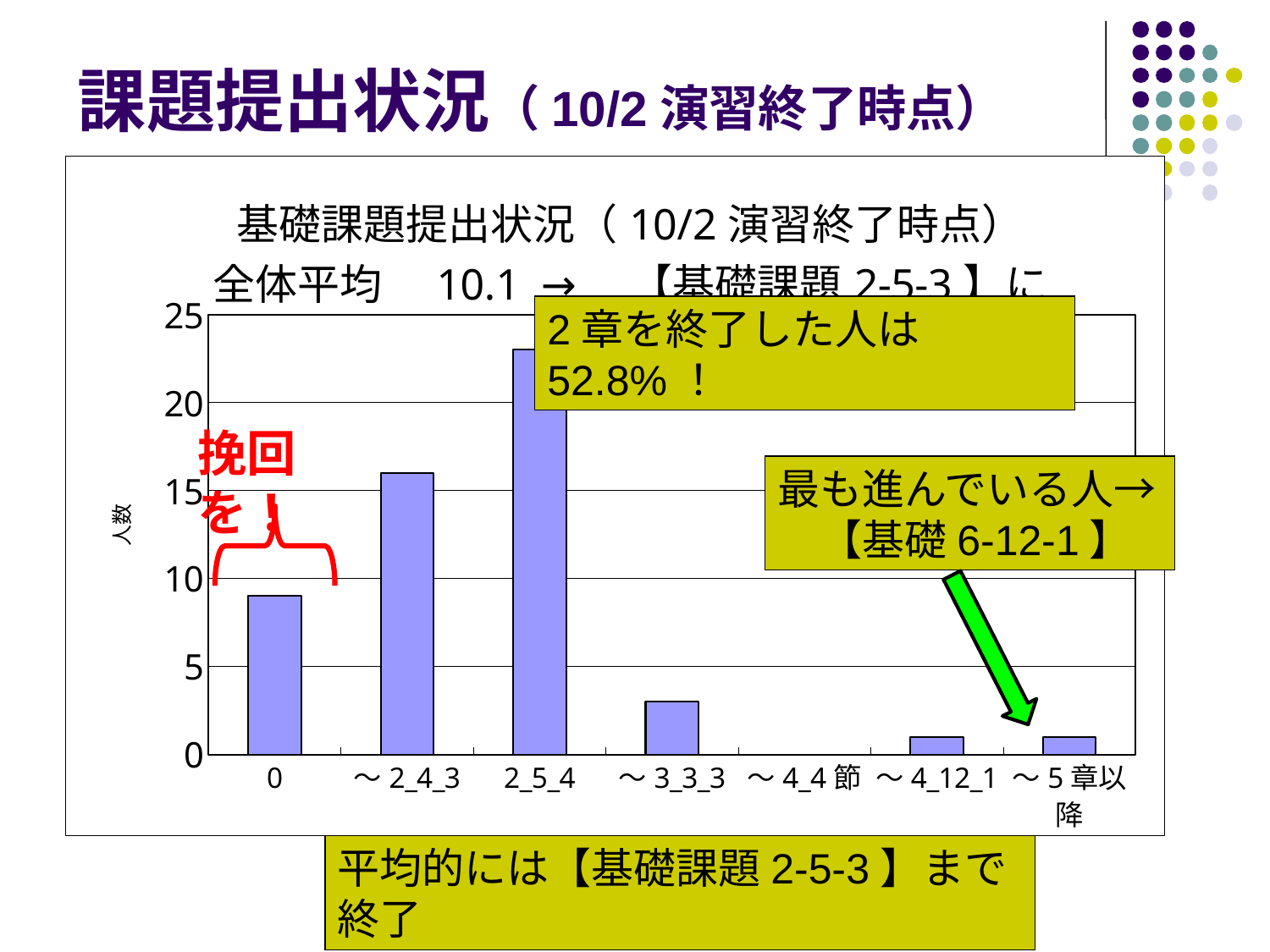
Is the value for ～3_3_3 greater or less than 5? less Which category has the lowest value (no visible bar) in the chart? ～4_4節 How many categories are shown on the x axis of the chart? 7 What is the label of the y axis of the chart? 人数 Which is larger, the value for the category 0 or the value for ～3_3_3? 0 Is the value for the category 0 greater or less than 10? less Is the value for ～2_4_3 greater or less than 15? greater What is the title of the chart? 基礎課題提出状況（10/2 演習終了時点） What kind of chart is shown on the slide? bar chart Which category has the highest bar in the chart? 2_5_4 Which is larger, the value for ～2_4_3 or the value for 2_5_4? 2_5_4